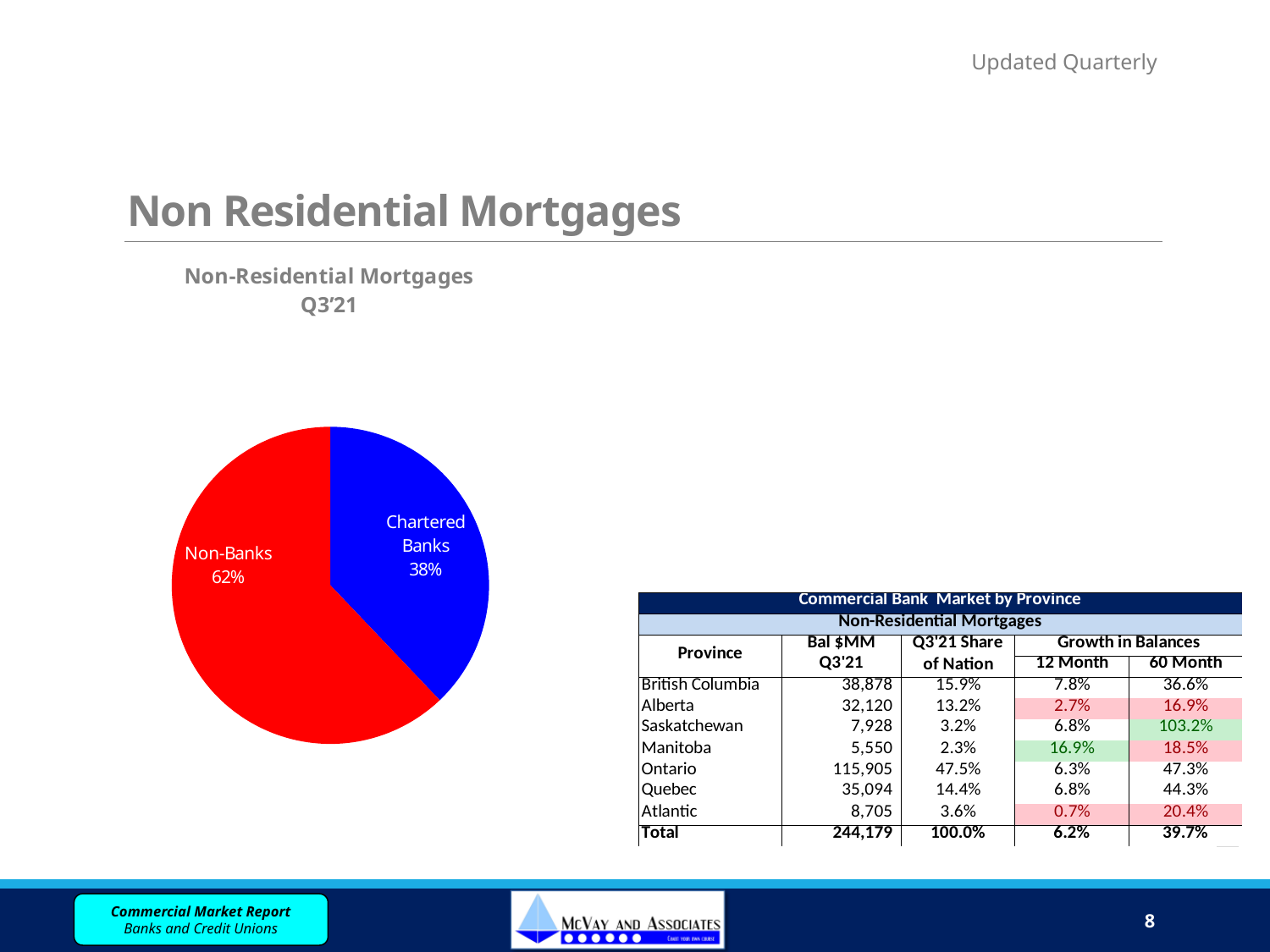
How many slices does the pie chart have? 2 Which slice of the pie chart is the smallest? Chartered Banks What is the difference in percentage points between the Non-Banks slice and the Chartered Banks slice? 24 What is the title of the pie chart? Non-Residential Mortgages Q3'21 What kind of chart is shown on the slide? pie chart Which is larger in the pie chart, Non-Banks or Chartered Banks? Non-Banks What share of the pie chart does Chartered Banks hold? 38% What share of the pie chart does Non-Banks hold? 62% What colour is the Non-Banks slice of the pie chart? red Which slice of the pie chart is the largest? Non-Banks